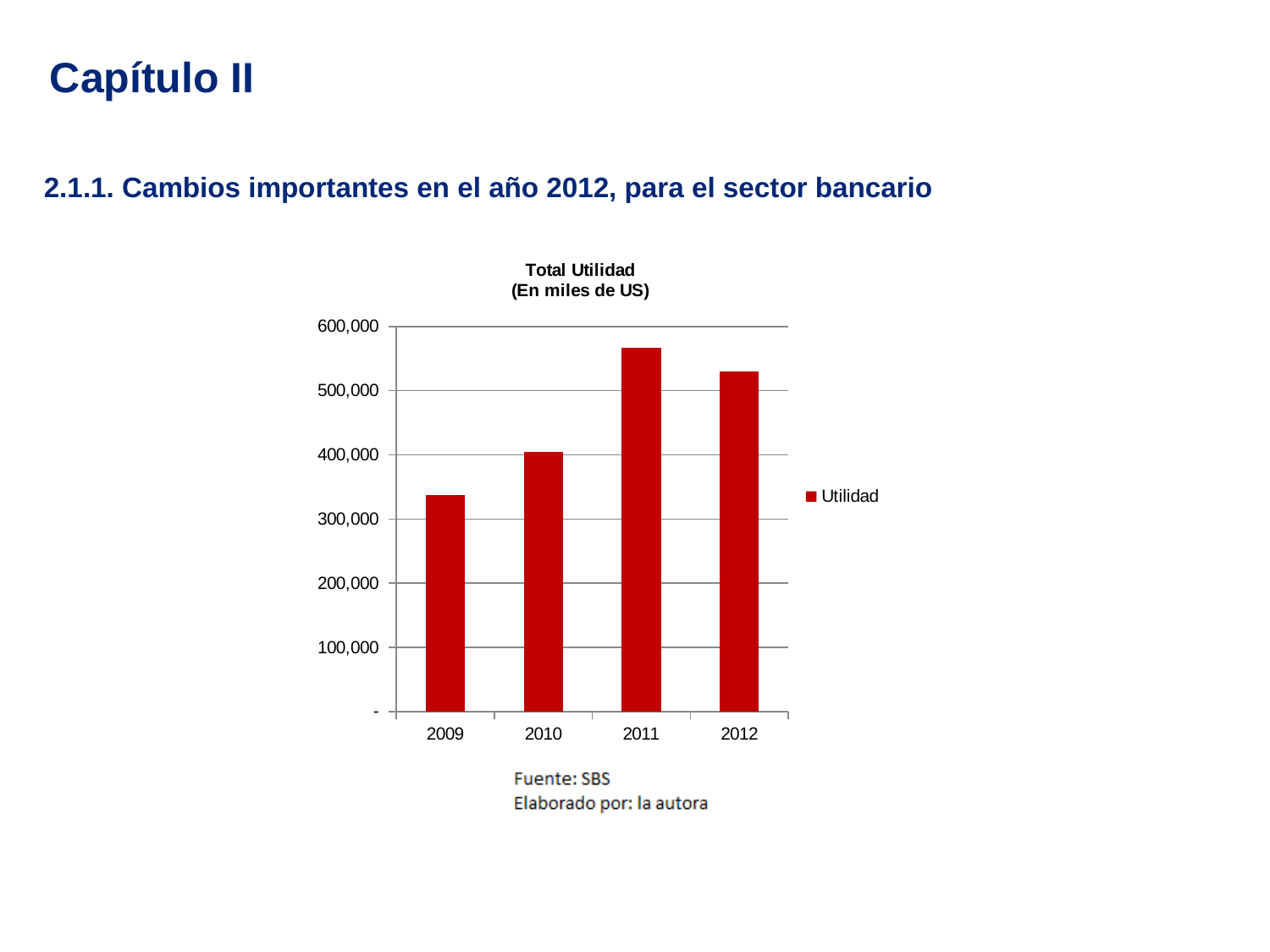
How many series does the legend list? 1 What is the title of the chart? Total Utilidad (En miles de US) What is the name of the series shown in the legend? Utilidad Which year has the larger Utilidad value, 2011 or 2012? 2011 Which year has the lowest Utilidad value? 2009 Does the Utilidad value rise or fall from 2011 to 2012? fall What kind of chart is shown on the slide? bar chart How many years are shown on the x axis of the chart? 4 Is the value for 2009 greater or less than 300,000? greater Is the value for 2012 greater or less than 500,000? greater Which year has the highest Utilidad value? 2011 Is the value for 2010 greater or less than 500,000? less